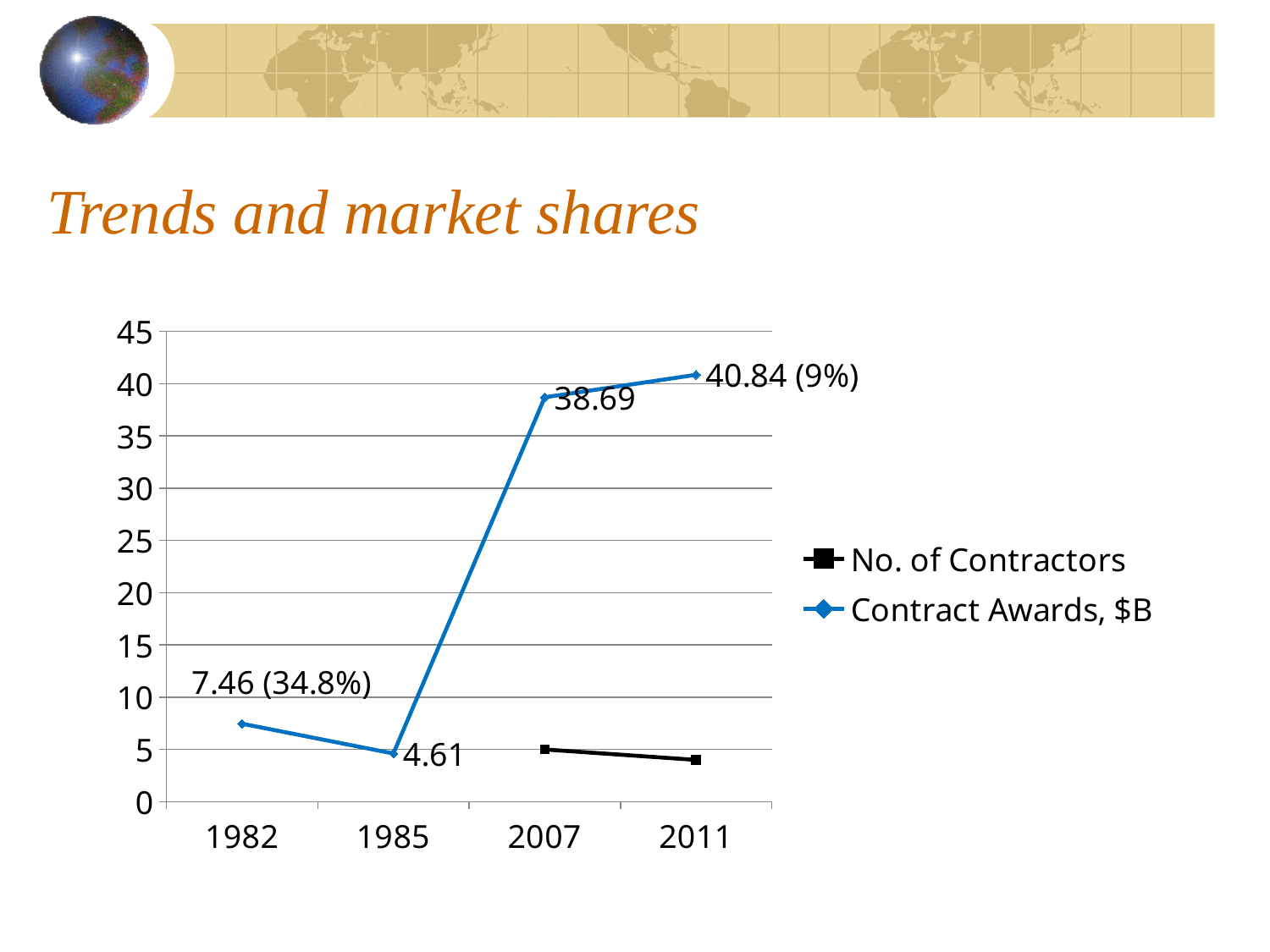
What is the difference in Contract Awards, $B between 2011 and 2007? 2.15 What is the Contract Awards, $B value for 2007? 38.69 In which year is Contract Awards, $B highest? 2011 How many series does the legend list? 2 What kind of chart is shown on the slide? line chart What is the Contract Awards, $B value for 1985? 4.61 How many years are shown on the x axis? 4 Is the No. of Contractors value for 2007 greater or less than 10? less Which year has the larger Contract Awards, $B value, 1982 or 1985? 1982 What data label is shown for Contract Awards, $B in 1982? 7.46 (34.8%) In which year is Contract Awards, $B lowest? 1985 What data label is shown for Contract Awards, $B in 2011? 40.84 (9%)